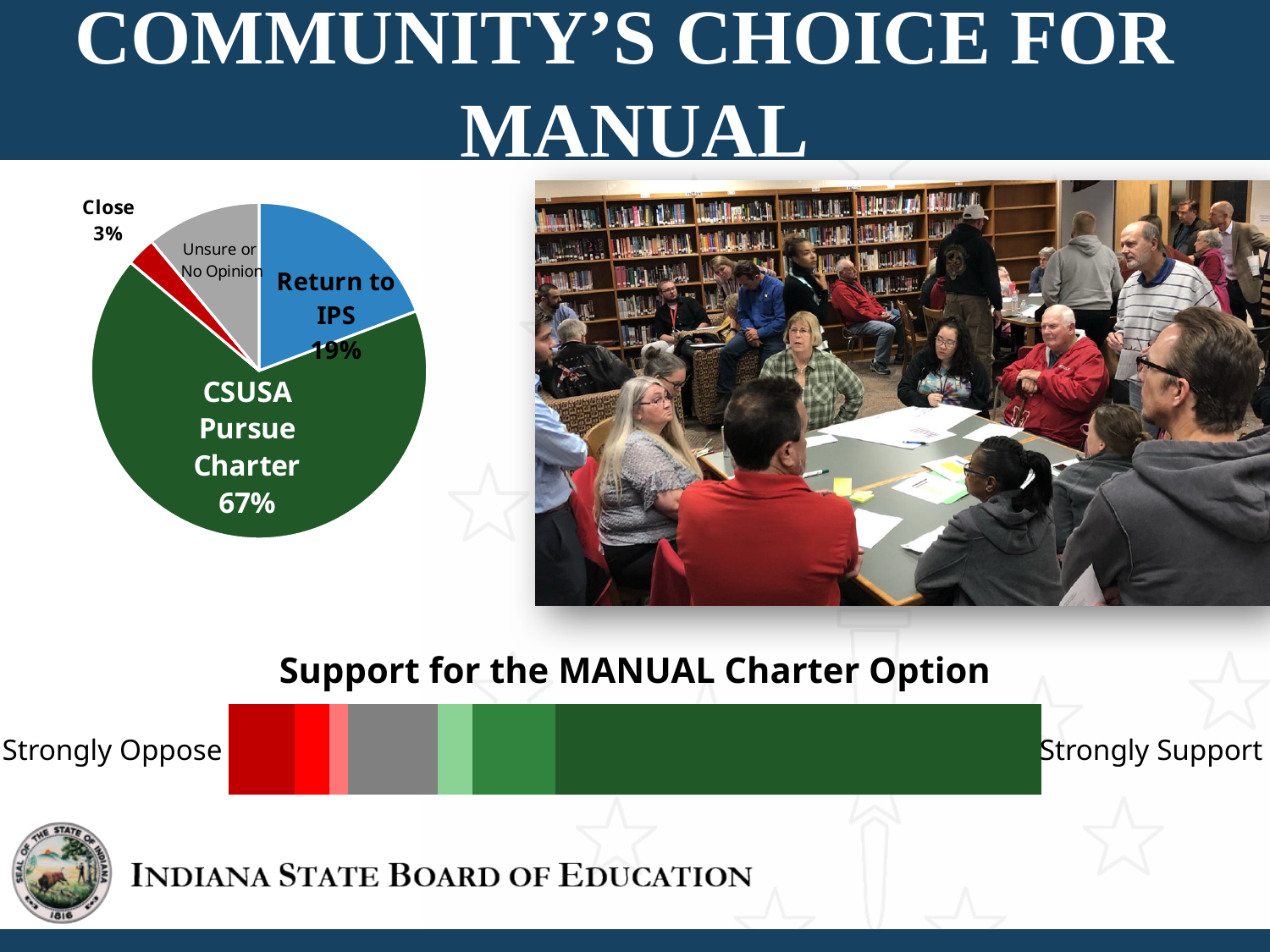
In the pie chart, what percentage chose Return to IPS? 19% What labels appear at the left and right ends of the bar at the bottom of the slide? Strongly Oppose and Strongly Support What kind of chart is shown under the heading 'Support for the MANUAL Charter Option'? Bar chart What is the title of the chart at the bottom of the slide? Support for the MANUAL Charter Option Which option has the smallest slice in the pie chart? Close Which option has the largest slice in the pie chart? CSUSA Pursue Charter What kind of chart is shown on the left of the slide? Pie chart How many slices does the pie chart have? 4 In the pie chart, what percentage chose CSUSA Pursue Charter? 67% In the pie chart, how many percentage points higher is CSUSA Pursue Charter than Return to IPS? 48 percentage points In the pie chart, which is larger: Return to IPS or Close? Return to IPS In the pie chart, what percentage chose Close? 3%